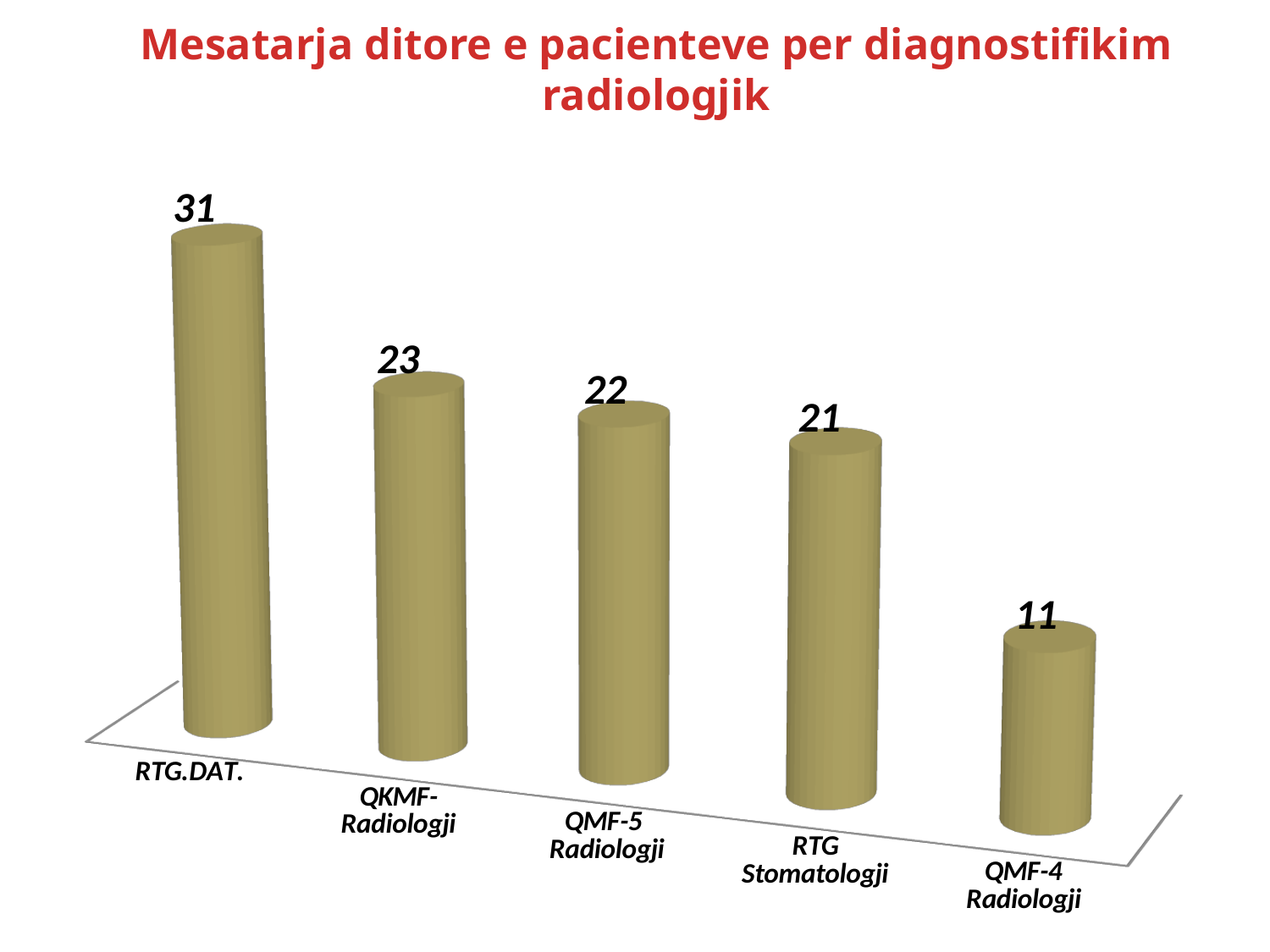
What is the value for RTG Stomatologji? 21 Which is larger, the value for QKMF-Radiologji or the value for RTG Stomatologji? QKMF-Radiologji Which category has the highest value? RTG.DAT. What is the value for QKMF-Radiologji? 23 What is the title of the chart? Mesatarja ditore e pacienteve per diagnostifikim radiologjik How many categories are shown in the chart? 5 What kind of chart is shown on the slide? Bar chart Which category has the lowest value? QMF-4 Radiologji What is the value for RTG.DAT.? 31 What is the value for QMF-4 Radiologji? 11 What is the difference between the values for RTG.DAT. and QMF-4 Radiologji? 20 What is the value for QMF-5 Radiologji? 22